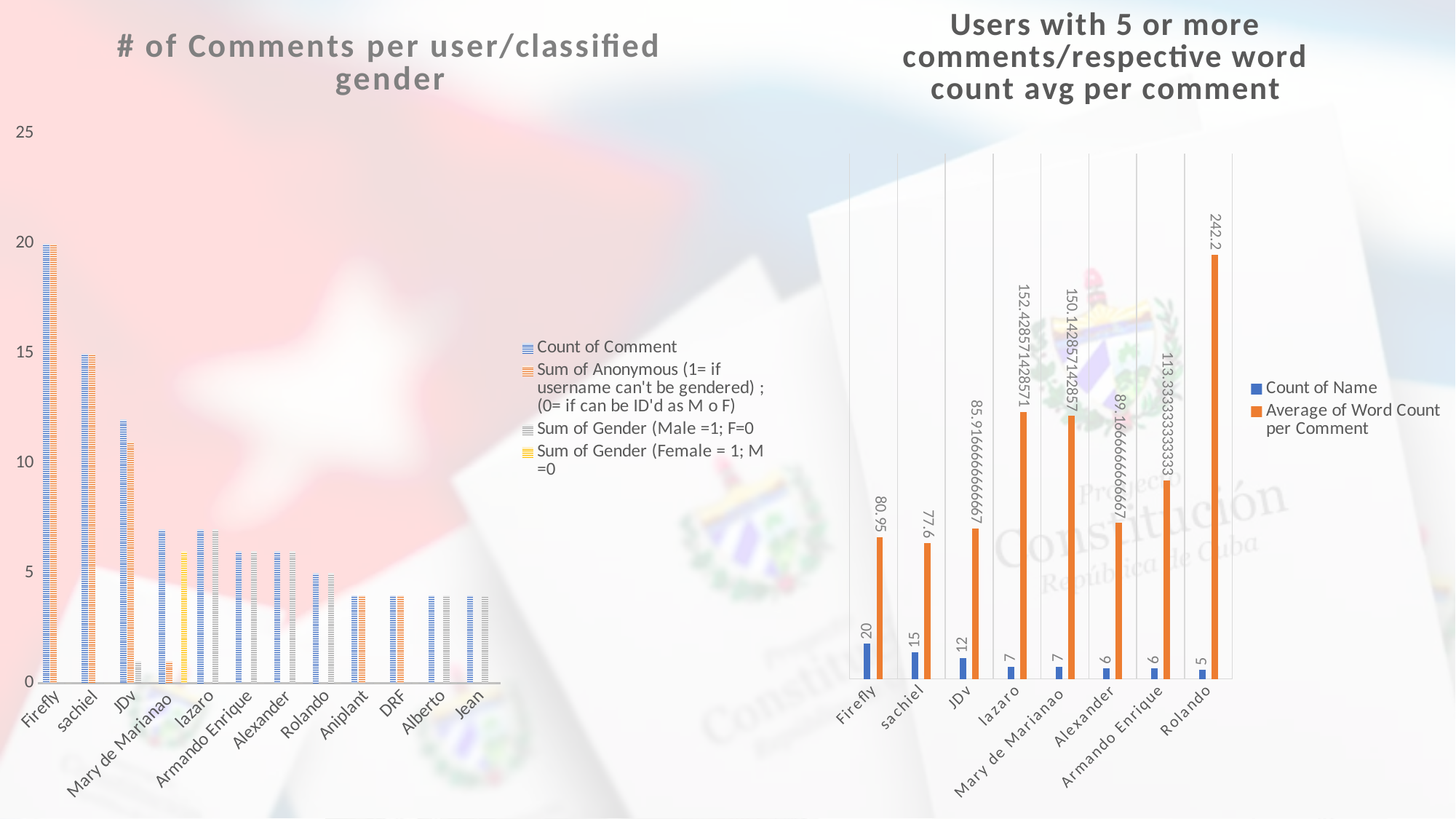
In the 'Users with 5 or more comments' chart, what is the Average of Word Count per Comment for sachiel? 77.6 How many users are shown on the x axis of the 'Users with 5 or more comments' chart? 8 How many series does the legend of the '# of Comments per user/classified gender' chart list? 4 In the 'Users with 5 or more comments' chart, what is the Average of Word Count per Comment for Rolando? 242.2 What kind of chart is the 'Users with 5 or more comments/respective word count avg per comment' chart? bar chart In the 'Users with 5 or more comments' chart, what is the Count of Name for Firefly? 20 In the 'Users with 5 or more comments' chart, what is the difference between the Count of Name for Firefly and for sachiel? 5 In the 'Users with 5 or more comments' chart, which user has the highest Average of Word Count per Comment? Rolando How many series does the legend of the 'Users with 5 or more comments' chart list? 2 In the '# of Comments per user/classified gender' chart, is the Count of Comment for sachiel greater or less than 10? greater In the 'Users with 5 or more comments' chart, who has the larger Average of Word Count per Comment, lazaro or Mary de Marianao? lazaro In the 'Users with 5 or more comments' chart, which user has the lowest Average of Word Count per Comment? sachiel